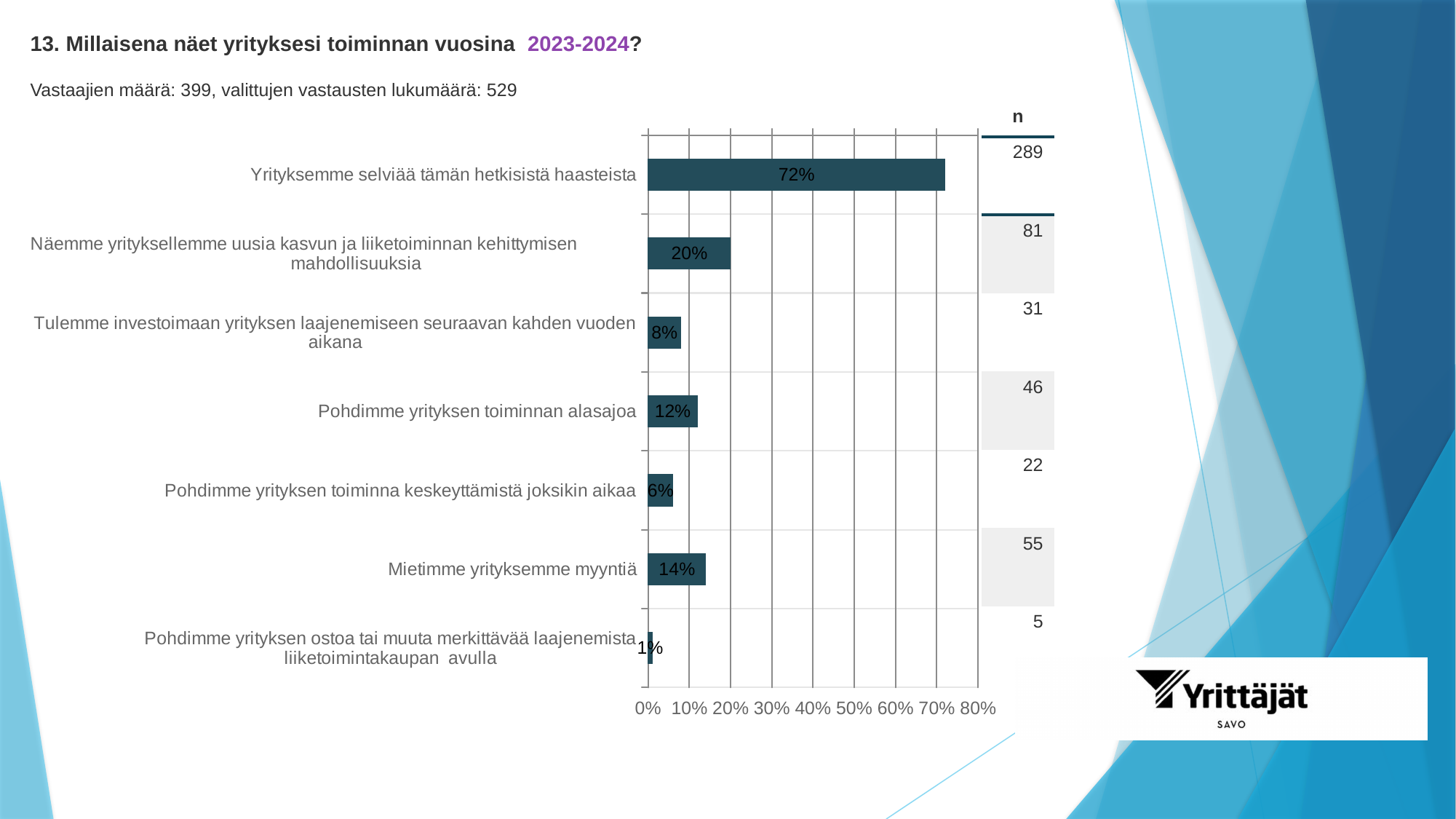
What kind of chart is shown on the slide? Bar chart What is the maximum value shown on the percentage axis? 80% Which has a higher percentage: "Pohdimme yrityksen toiminnan alasajoa" or "Tulemme investoimaan yrityksen laajenemiseen seuraavan kahden vuoden aikana"? Pohdimme yrityksen toiminnan alasajoa What percentage is shown for "Mietimme yrityksemme myyntiä"? 14% What percentage of respondents chose "Yrityksemme selviää tämän hetkisistä haasteista"? 72% Which category has the highest percentage? Yrityksemme selviää tämän hetkisistä haasteista What is the n value shown for "Näemme yrityksellemme uusia kasvun ja liiketoiminnan kehittymisen mahdollisuuksia"? 81 Which category has the lowest percentage? Pohdimme yrityksen ostoa tai muuta merkittävää laajenemista liiketoimintakaupan avulla How many categories are shown in the chart? 7 Is the value for "Yrityksemme selviää tämän hetkisistä haasteista" greater or less than 60%? greater What is the difference in percentage points between "Yrityksemme selviää tämän hetkisistä haasteista" and "Näemme yrityksellemme uusia kasvun ja liiketoiminnan kehittymisen mahdollisuuksia"? 52 percentage points What is the n value for "Pohdimme yrityksen toiminna keskeyttämistä joksikin aikaa"? 22